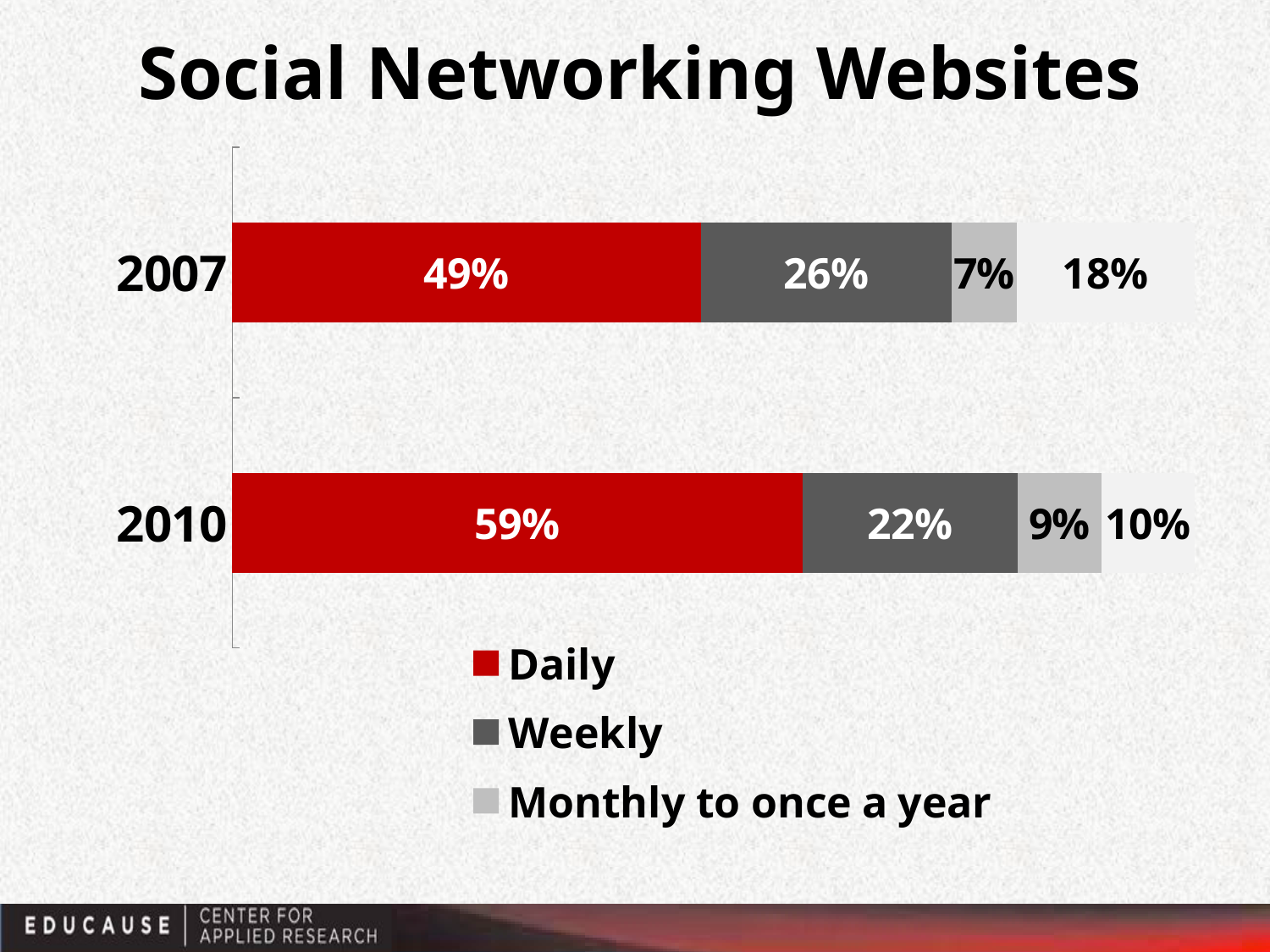
Which year has the larger Weekly value, 2007 or 2010? 2007 What is the difference between the Monthly to once a year values for 2010 and 2007? 2 percentage points How many series does the legend list? 3 How many years (categories) are shown in the chart? 2 Which year has the higher Daily value? 2010 What is the Weekly value for 2010? 22% By how many percentage points did the Daily value increase from 2007 to 2010? 10 percentage points What is the Daily value for 2010? 59% What type of chart is shown on the slide? Stacked bar chart What percentage of the 2007 bar is labelled Daily? 49% What is the title of the chart? Social Networking Websites What is the Monthly to once a year value for 2007? 7%